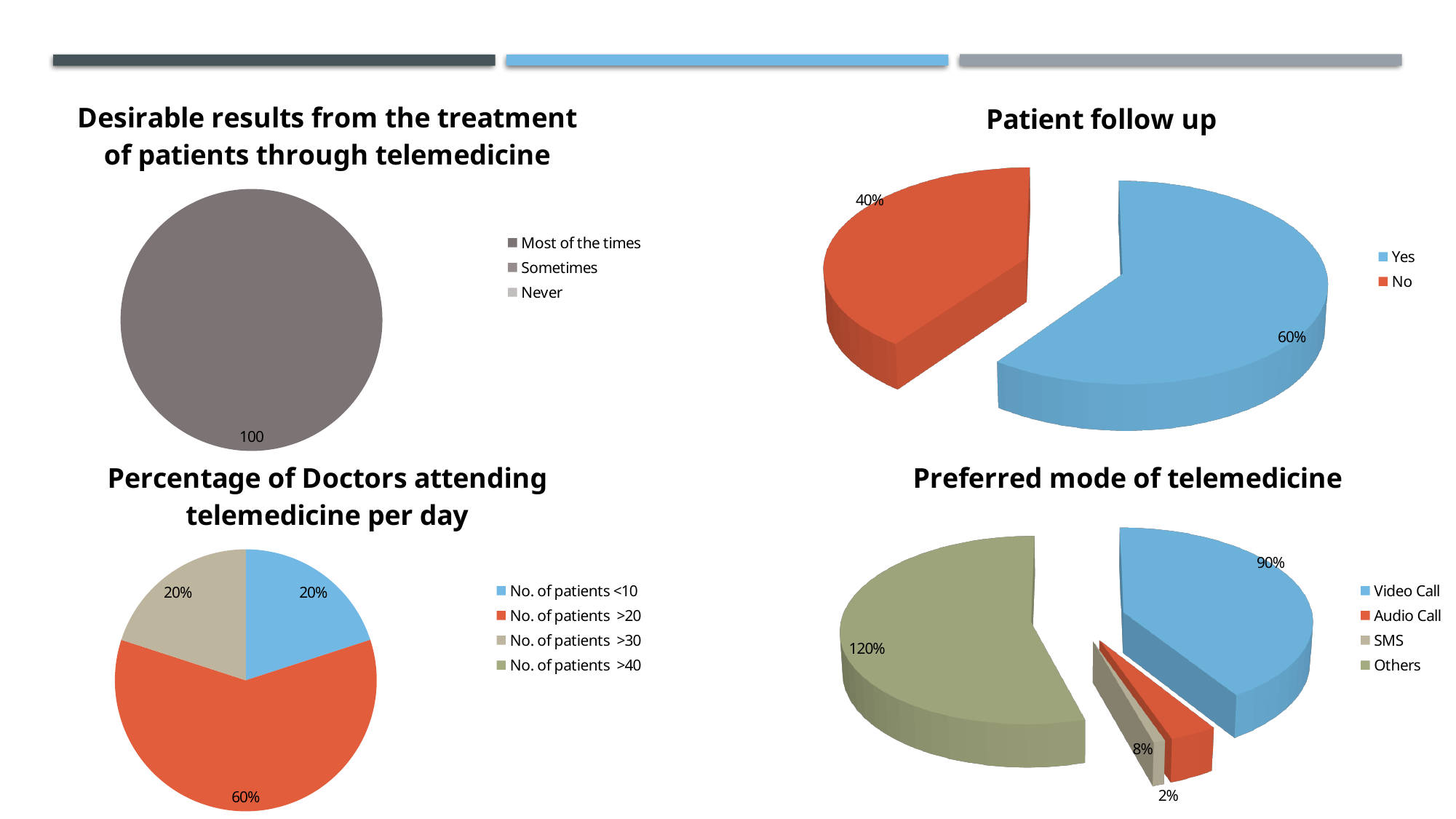
In the 'Percentage of Doctors attending telemedicine per day' chart, which category has the largest slice? No. of patients >20 In the 'Percentage of Doctors attending telemedicine per day' chart, what percentage is shown for No. of patients >20? 60% In the 'Preferred mode of telemedicine' chart, which category has the smallest slice? SMS In the 'Patient follow up' chart, what percentage is shown for Yes? 60% In the 'Desirable results from the treatment of patients through telemedicine' chart, what value is printed on the single slice? 100 What type of chart is 'Desirable results from the treatment of patients through telemedicine'? Pie chart In the 'Patient follow up' chart, what is the difference between the Yes and No percentages? 20% In the 'Patient follow up' chart, which category has the larger share, Yes or No? Yes In the 'Patient follow up' chart, what percentage is shown for No? 40% In the 'Preferred mode of telemedicine' chart, what percentage is shown for Others? 120% In the 'Preferred mode of telemedicine' chart, what percentage is shown for Video Call? 90% In the 'Percentage of Doctors attending telemedicine per day' chart, how many entries does the legend list? 4